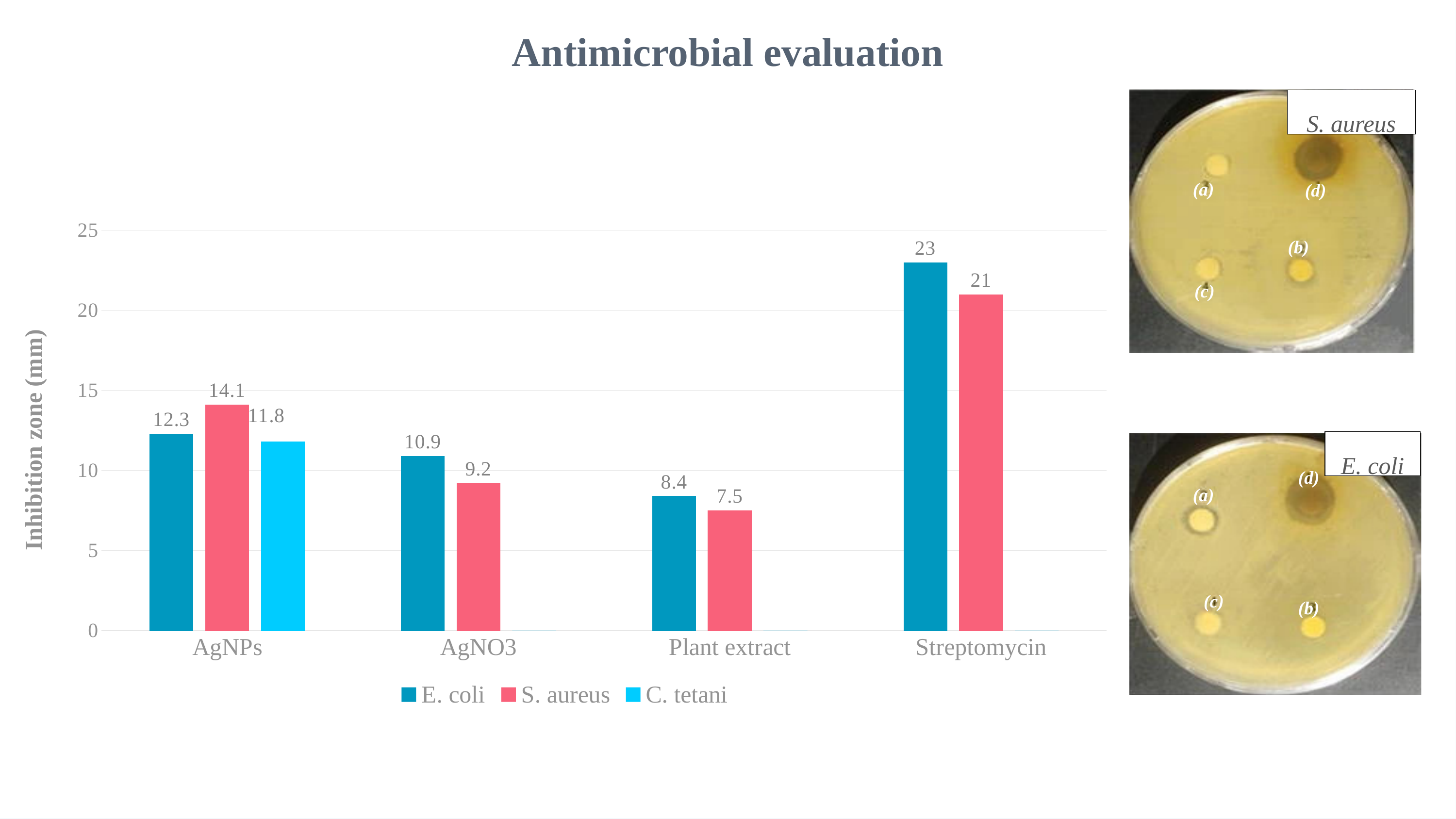
What type of chart is shown on the slide? bar chart How many series does the legend list? 3 Which treatment has the highest inhibition zone for E. coli? Streptomycin What is the inhibition zone for C. tetani with AgNPs? 11.8 What is the difference between the E. coli and S. aureus inhibition zones for Streptomycin? 2 What is the inhibition zone for S. aureus with Streptomycin? 21 What is the inhibition zone for E. coli with AgNPs? 12.3 Which is larger for AgNO3: the E. coli value or the S. aureus value? E. coli Which treatment has the lowest inhibition zone for S. aureus? Plant extract Is the E. coli value for Plant extract greater or less than 10? less What is the difference between the S. aureus and E. coli inhibition zones for AgNPs? 1.8 How many treatment categories are shown on the x axis? 4